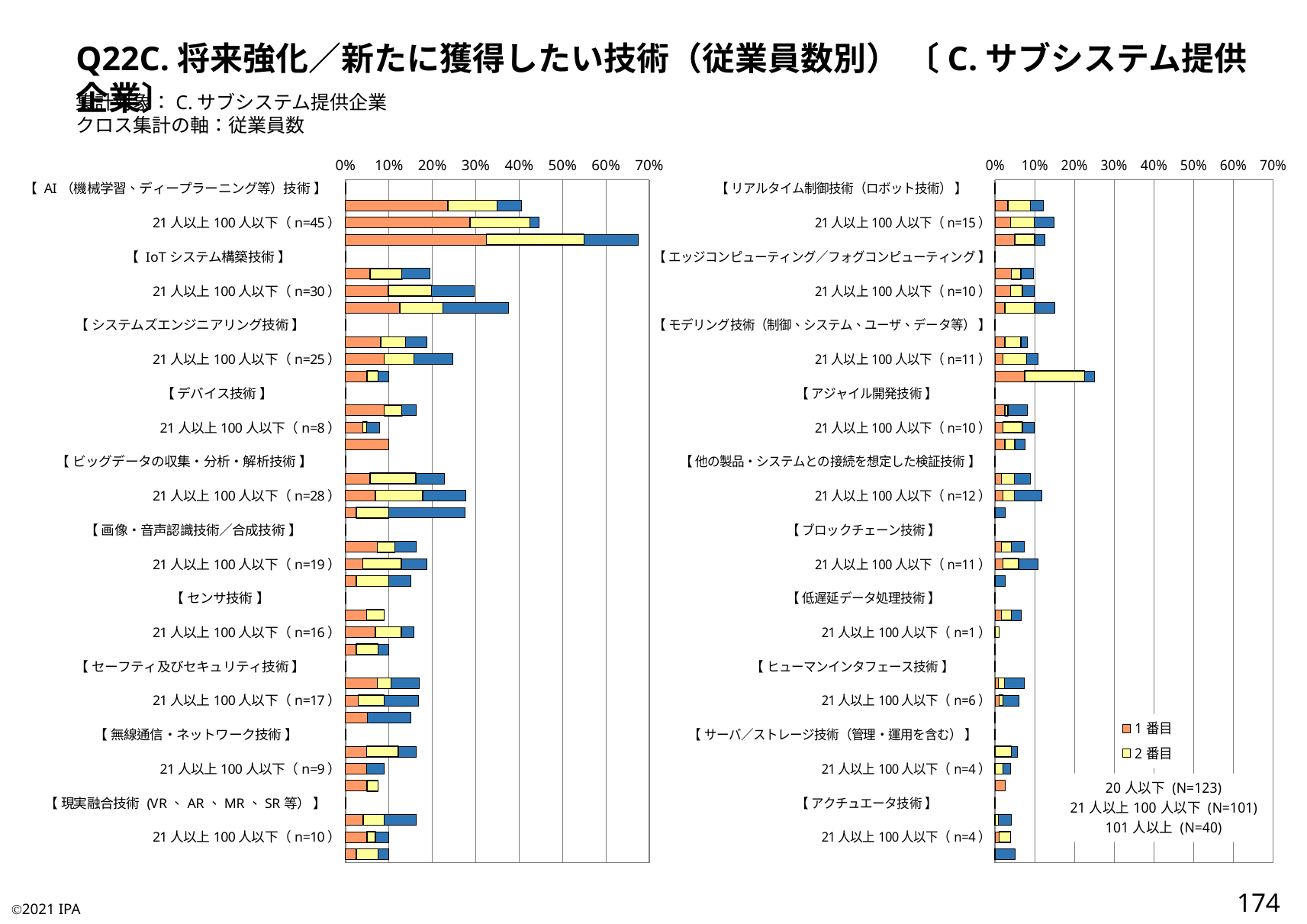
On the left chart, is the total value of the longest bar in the AI (機械学習、ディープラーニング等) 技術 group greater or less than 60%? greater On the left chart, is the total value of the 21人以上100人以下 (n=45) bar in the AI 技術 group greater or less than 40%? greater On the left chart, which is larger: the third (bottom) bar of the AI 技術 group or the third (bottom) bar of the IoT システム構築技術 group? AI 技術 How many technology groups are listed on the left chart? 10 On the left chart, which technology group contains the longest bar? AI（機械学習、ディープラーニング等）技術 On the left chart, what is the maximum value shown on the horizontal axis? 70% How many technology groups are listed on the right chart? 10 On the right chart, is the total value of the third (bottom) bar in the モデリング技術 group greater or less than 20%? greater On the right chart, which technology group contains the longest bar? モデリング技術（制御、システム、ユーザ、データ等） What kind of chart is shown on the left side of the slide? Stacked horizontal bar chart According to the note on the right chart, what is N for 101人以上? 40